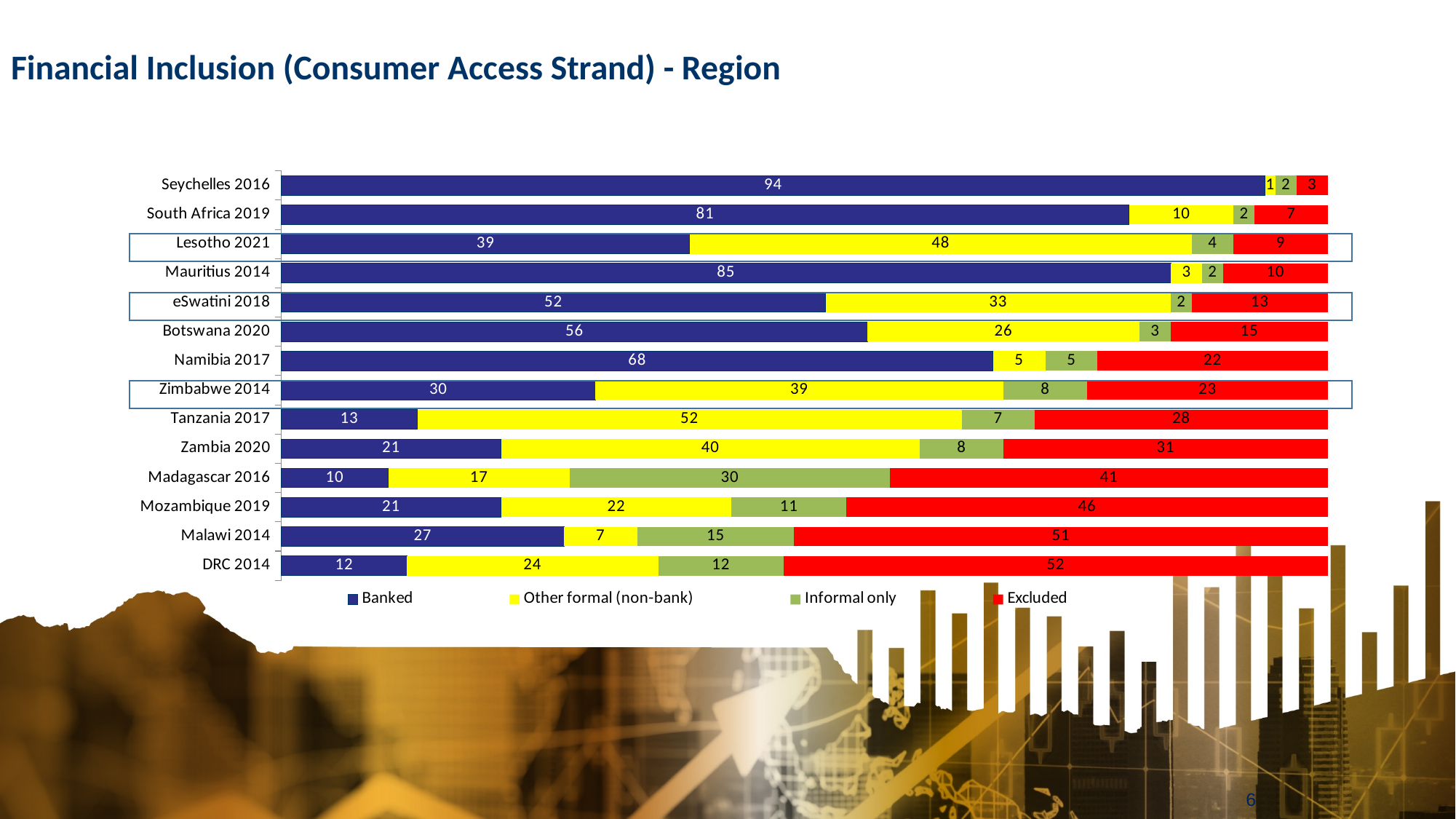
What is the Banked value for Lesotho 2021? 39 What is the Informal only value for Malawi 2014? 15 What is the difference between the Banked values for South Africa 2019 and Botswana 2020? 25 What is the total of the stacked bar for Zimbabwe 2014? 100 What is the Excluded value for Madagascar 2016? 41 Which country has the highest Excluded value? DRC 2014 How many countries are shown in the chart? 14 Which country has the highest Banked value? Seychelles 2016 Which country has the lowest Banked value? Madagascar 2016 What is the Other formal (non-bank) value for Tanzania 2017? 52 Which is larger, the Excluded value for Zambia 2020 or for Namibia 2017? Zambia 2020 How many series does the legend list? 4